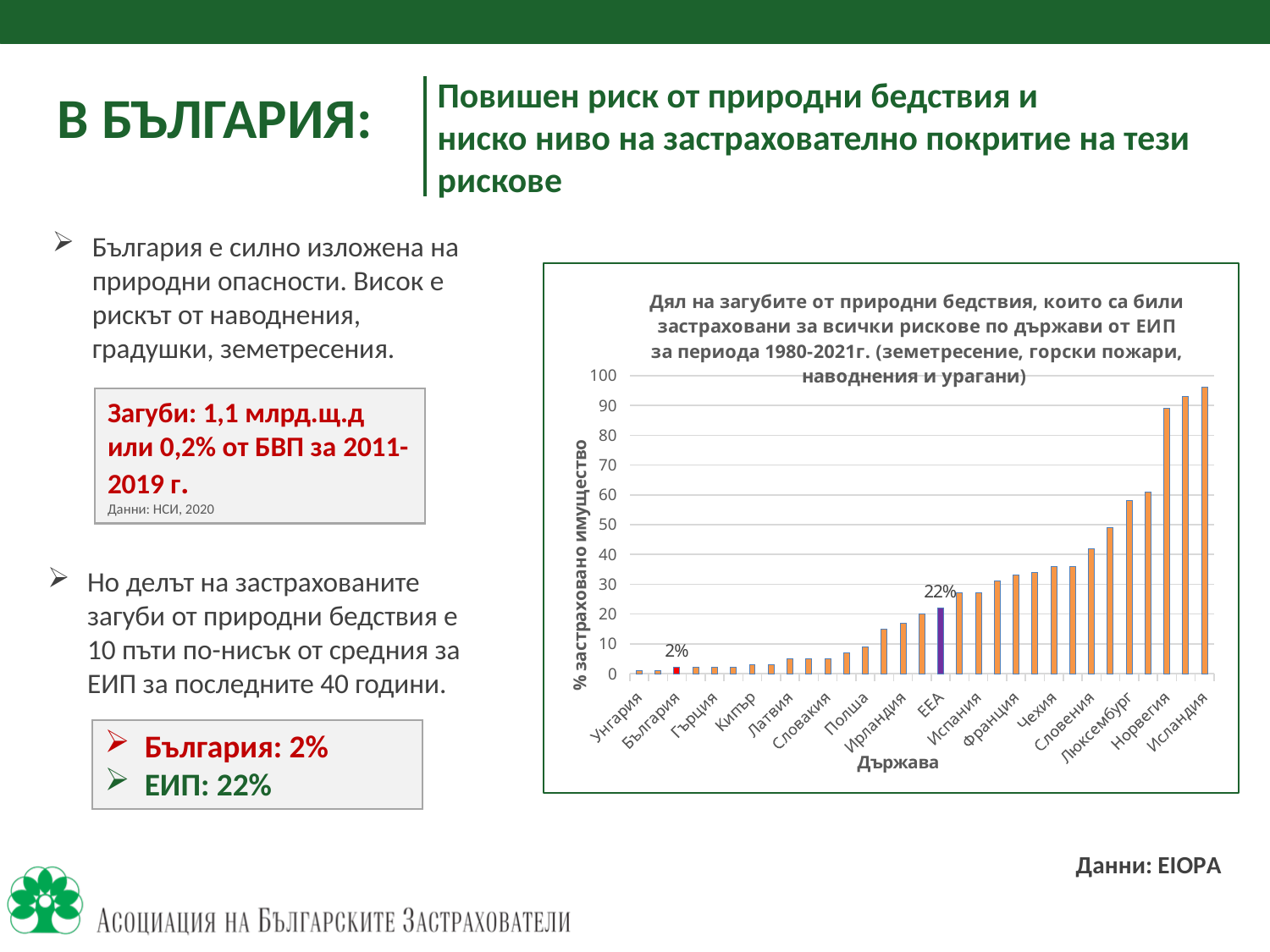
Which has the larger value, Норвегия or Испания? Норвегия Do the values rise or fall moving from left to right along the x axis? rise Is the value for Унгария greater or less than 10? less Which country has the highest value in the chart? Исландия What is the value shown for България (Bulgaria) in the chart? 2% What is the difference between the value for ЕЕА and the value for България? 20% Is the value for Люксембург greater or less than 50? greater What kind of chart is shown on the slide? bar chart What is the title of the chart's y axis? % застраховано имущество What is the value shown for ЕЕА in the chart? 22% Is the value for Исландия greater or less than 90? greater Which has the larger value, ЕЕА or България? ЕЕА